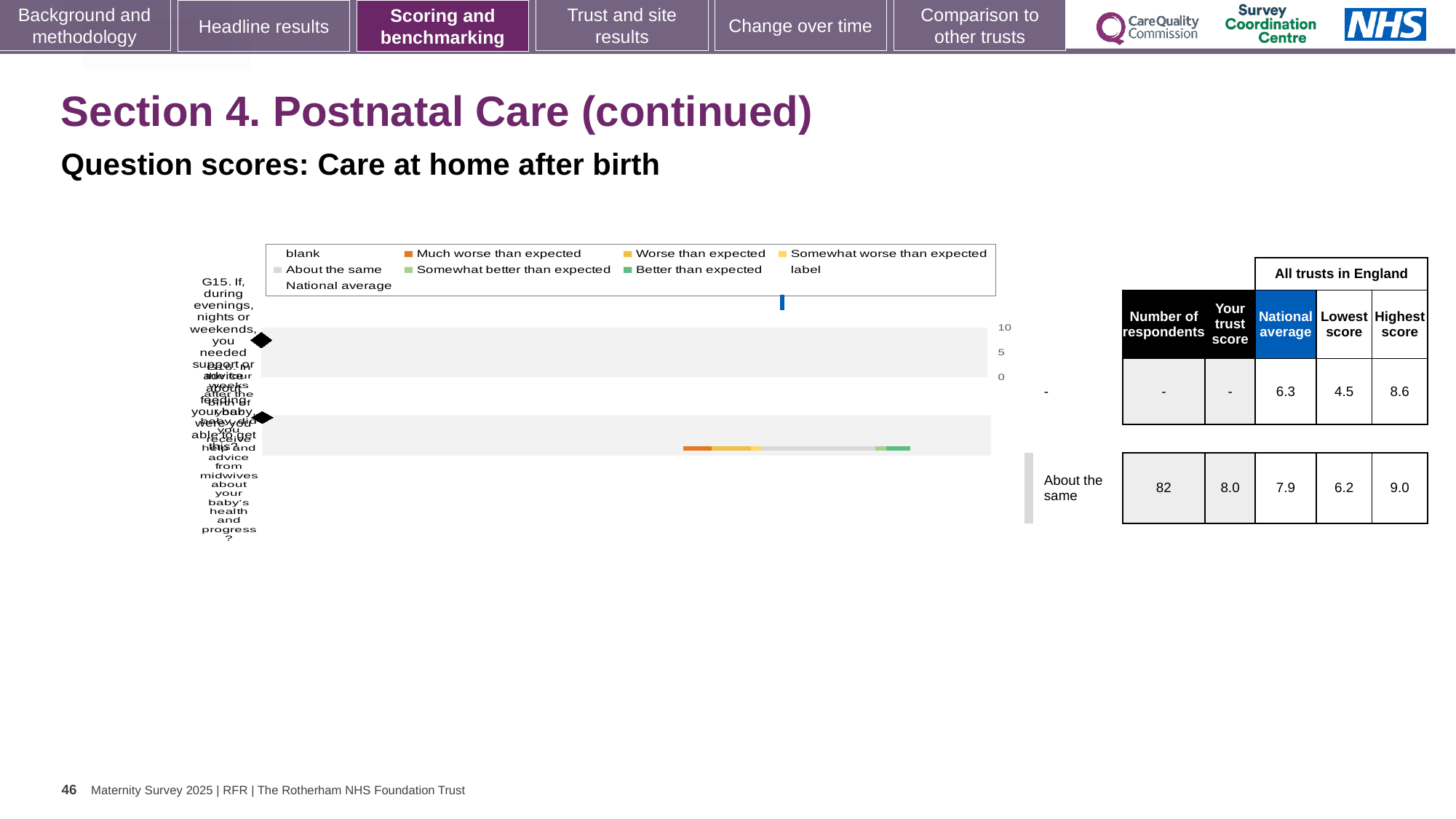
What kind of chart is shown on the slide? bar chart In the table beside the chart, how many respondents are listed for the row labelled 'About the same'? 82 In the chart legend, what colour represents 'Much worse than expected'? orange In the table beside the chart, what is the highest score for the row labelled 'About the same'? 9.0 In the table beside the chart, what is the national average in the first row? 6.3 In the table beside the chart, what is the 'Your trust score' for the row labelled 'About the same'? 8.0 In the table beside the chart, what is the lowest score in the first row? 4.5 In the chart legend, what colour represents 'Better than expected'? green In the table beside the chart, what is the national average for the row labelled 'About the same'? 7.9 In the table beside the chart, is the trust score for 'About the same' larger or smaller than the national average for that row? larger